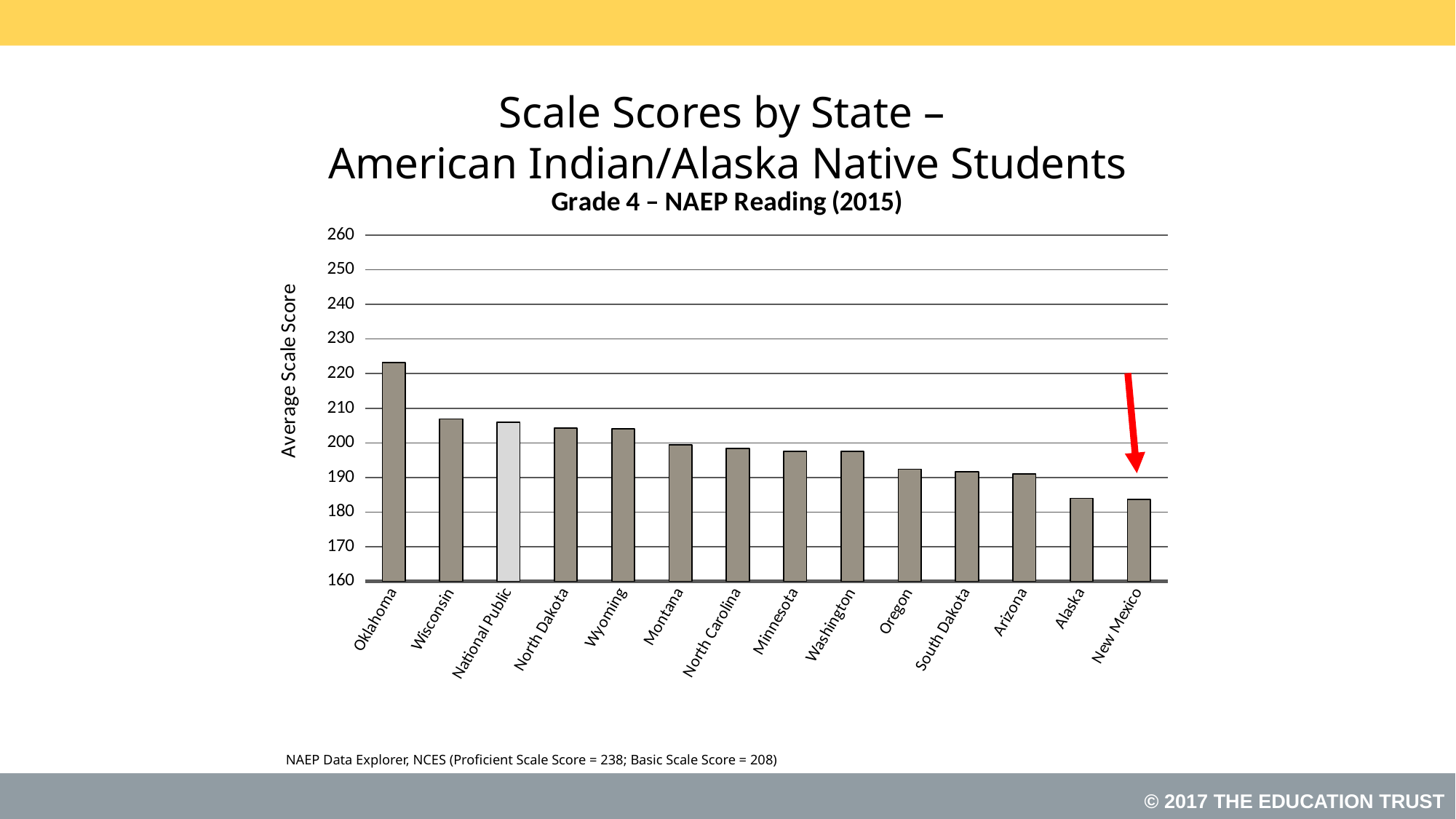
Is the value for Wisconsin greater or less than 210? less Is the value for Oklahoma greater or less than 220? greater Which is larger, the value for Oklahoma or the value for Wisconsin? Oklahoma Is the value for Alaska greater or less than 190? less Do the values rise or fall moving from left to right along the x axis? fall What kind of chart is shown on the slide? bar chart What is the title of the vertical axis? Average Scale Score Which is larger, the value for Wyoming or the value for Oregon? Wyoming How many bars are plotted in the chart? 14 Which state has the highest average scale score? Oklahoma